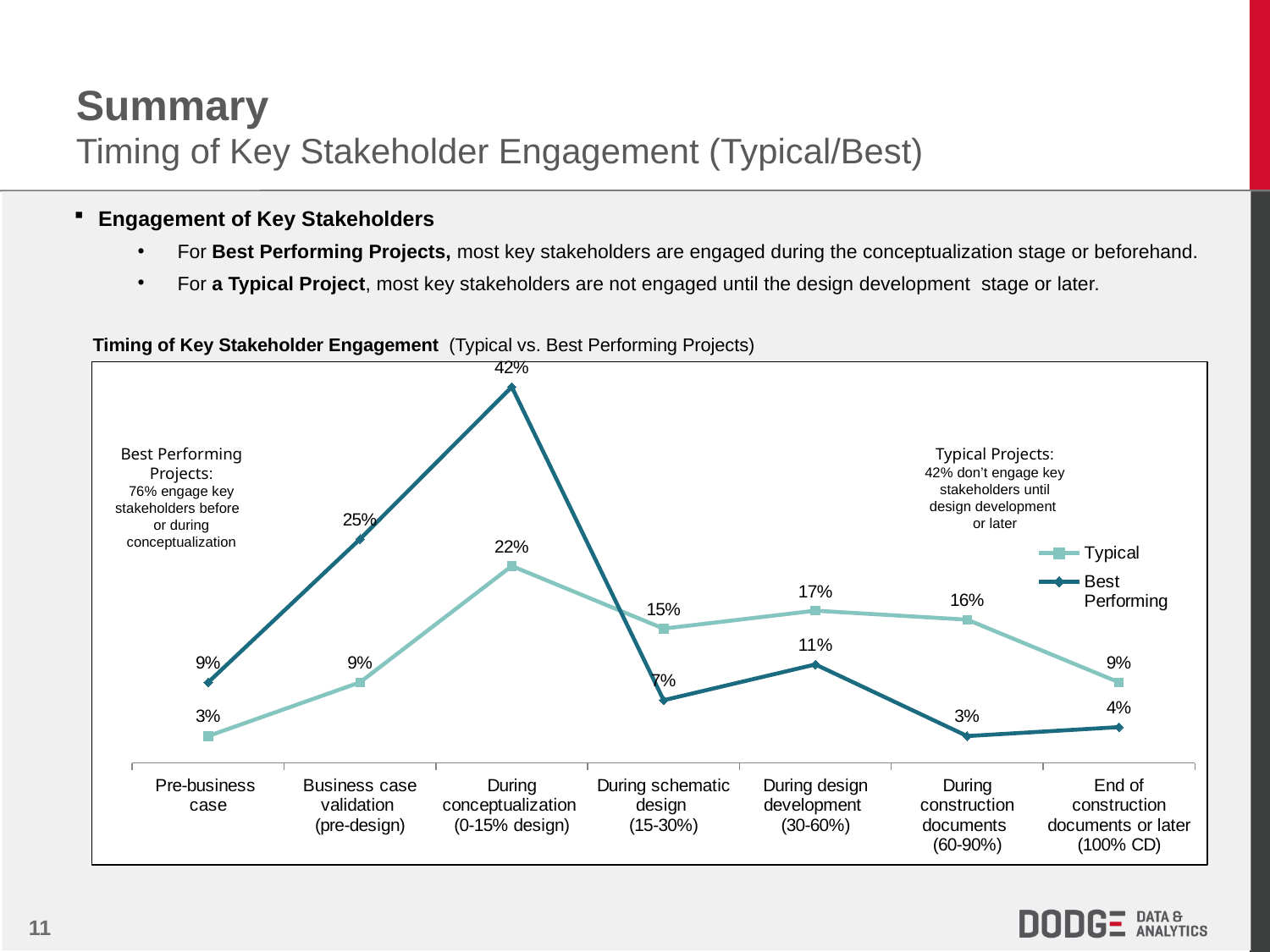
What is the Best Performing value for During conceptualization (0-15% design)? 42% How many series does the legend list? 2 What is the title of the chart? Timing of Key Stakeholder Engagement (Typical vs. Best Performing Projects) Which series has the larger value for During construction documents (60-90%), Typical or Best Performing? Typical What is the difference between the Best Performing and Typical values for During conceptualization (0-15% design)? 20% Does the Best Performing series rise or fall from During conceptualization (0-15% design) to During schematic design (15-30%)? Fall What type of chart is shown on the slide? Line chart How many categories are shown on the x axis? 7 What is the Typical value for Pre-business case? 3% Which category has the lowest Typical value? Pre-business case Which category has the highest Best Performing value? During conceptualization (0-15% design) What is the Typical value for During design development (30-60%)? 17%